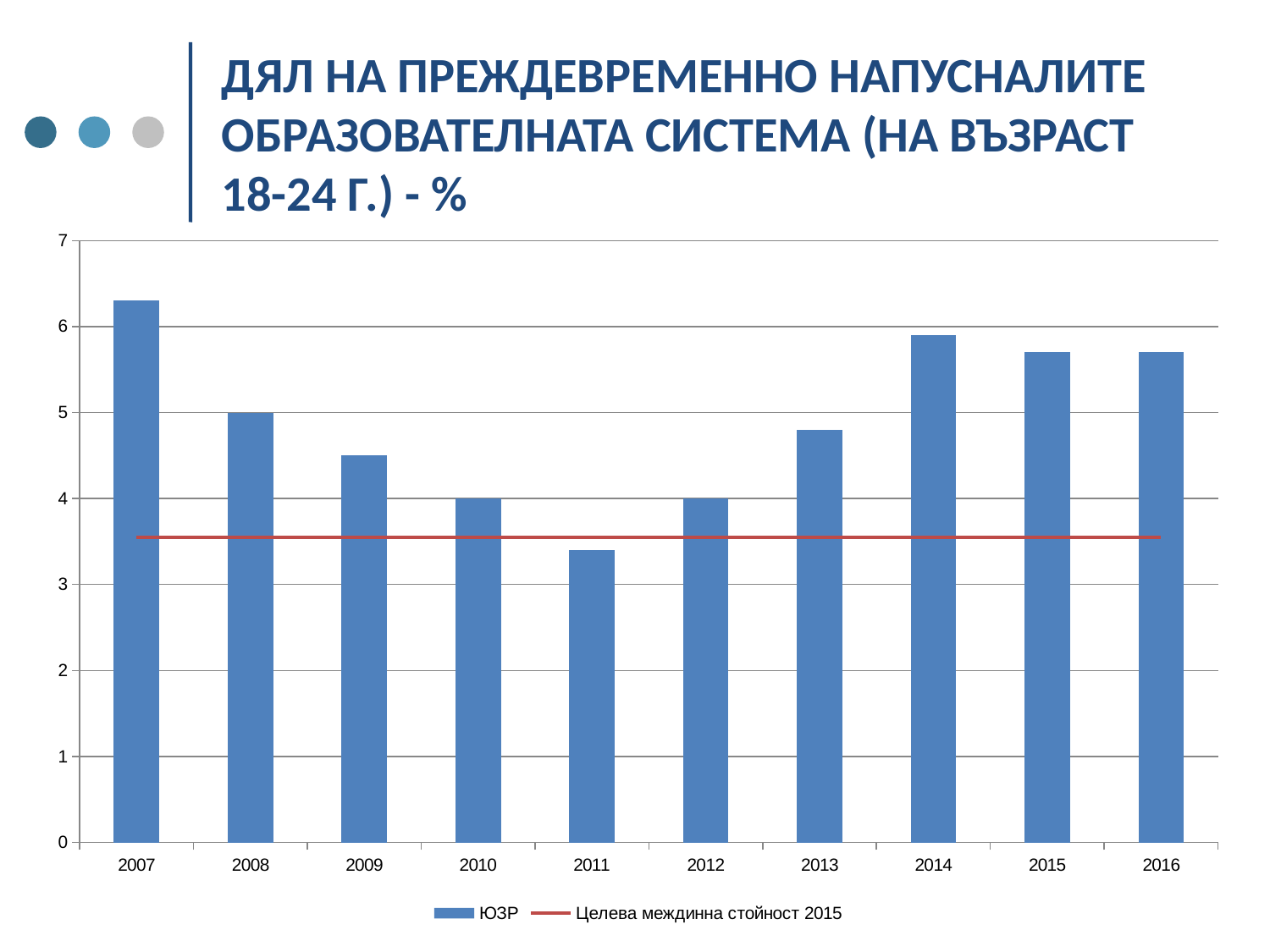
Is the value for ЮЗР in 2007 greater or less than 6? greater Do the ЮЗР values rise or fall from 2007 to 2011? fall Which year has the highest value for ЮЗР? 2007 What is the value for ЮЗР in 2008? 5 Is the value for ЮЗР in 2011 greater or less than 4? less What type of chart is shown on the slide? Combination bar and line chart Which year has the larger value for ЮЗР, 2007 or 2014? 2007 What is the value for ЮЗР in 2010? 4 How many years are shown on the x axis of the chart? 10 Which year has the lowest value for ЮЗР? 2011 How many series does the chart legend list? 2